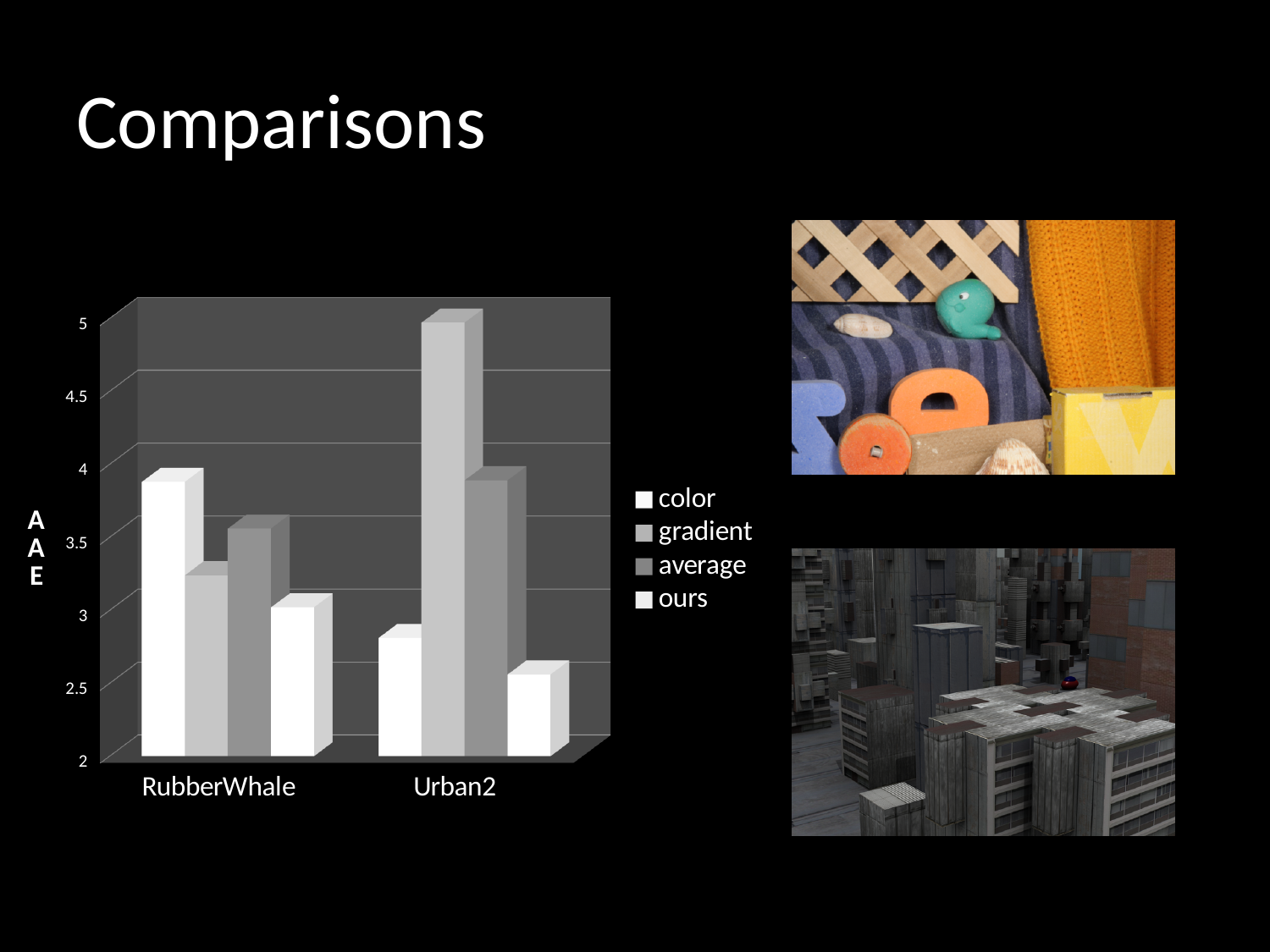
Is the value for gradient on Urban2 greater or less than 4.5? greater How many series does the chart's legend list? 4 Which series has the lowest value for Urban2? ours Which series has the highest value for RubberWhale? color What kind of chart is shown on the slide? bar chart Which series has the highest value for Urban2? gradient Is the value for color on RubberWhale greater or less than 3.5? greater How many categories are shown on the x axis of the chart? 2 Is the value for ours on Urban2 greater or less than 3? less Which is larger: the color value for RubberWhale or the color value for Urban2? RubberWhale Which series is listed last in the chart's legend? ours What is the label on the vertical axis of the chart? AAE